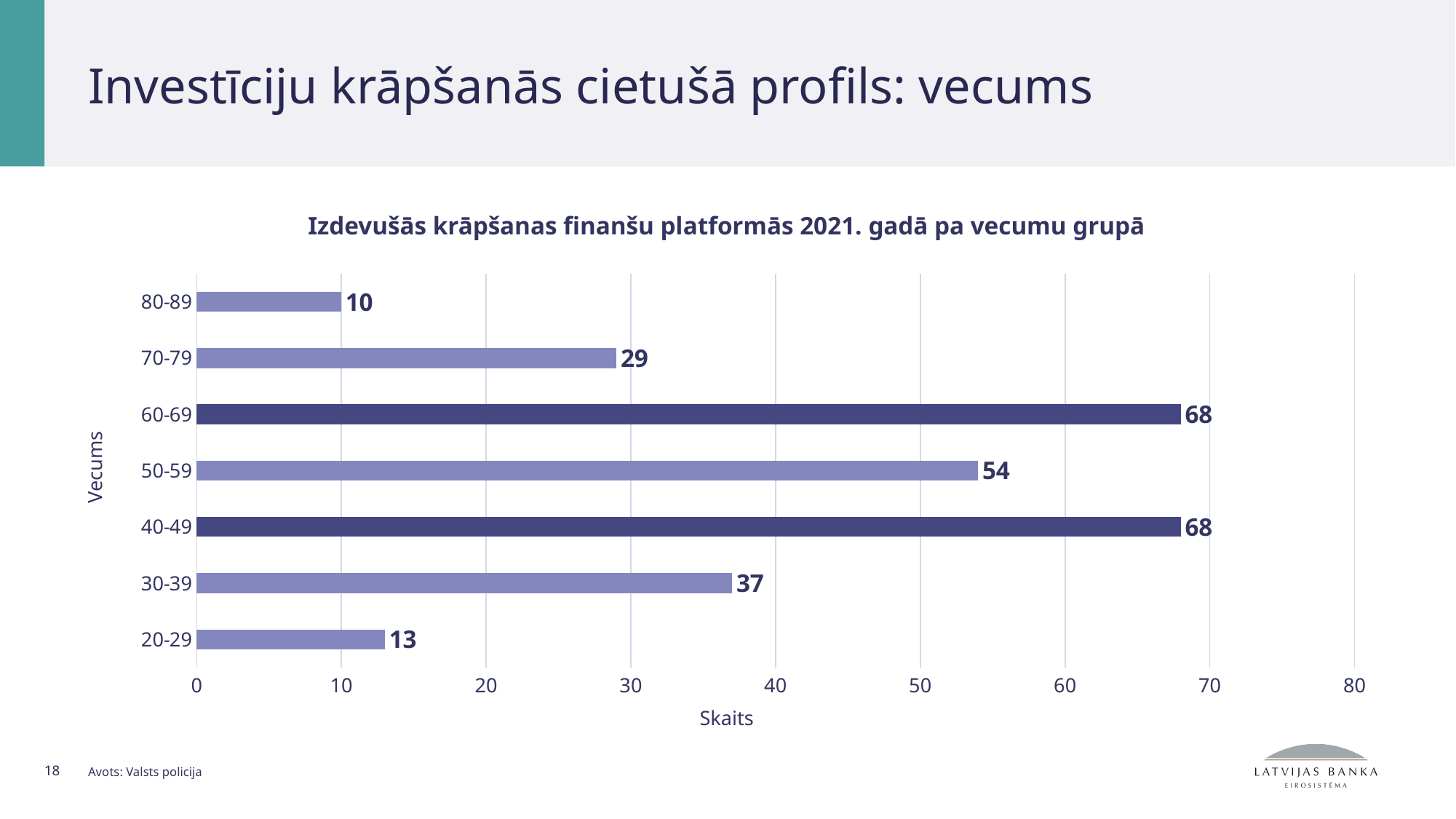
What is the value for the 70-79 age group? 29 Which age group has the lowest value? 80-89 Which age groups share the highest value? 40-49 and 60-69 What is the difference between the values for 60-69 and 50-59? 14 What is the value for the 20-29 age group? 13 What is the value for the 50-59 age group? 54 What is the title of the chart? Izdevušās krāpšanas finanšu platformās 2021. gadā pa vecumu grupā Which is larger, the value for 30-39 or the value for 70-79? 30-39 What is the difference between the values for 30-39 and 20-29? 24 Is the value for 50-59 greater or less than 50? greater How many age groups are shown in the chart? 7 What kind of chart is shown on the slide? bar chart